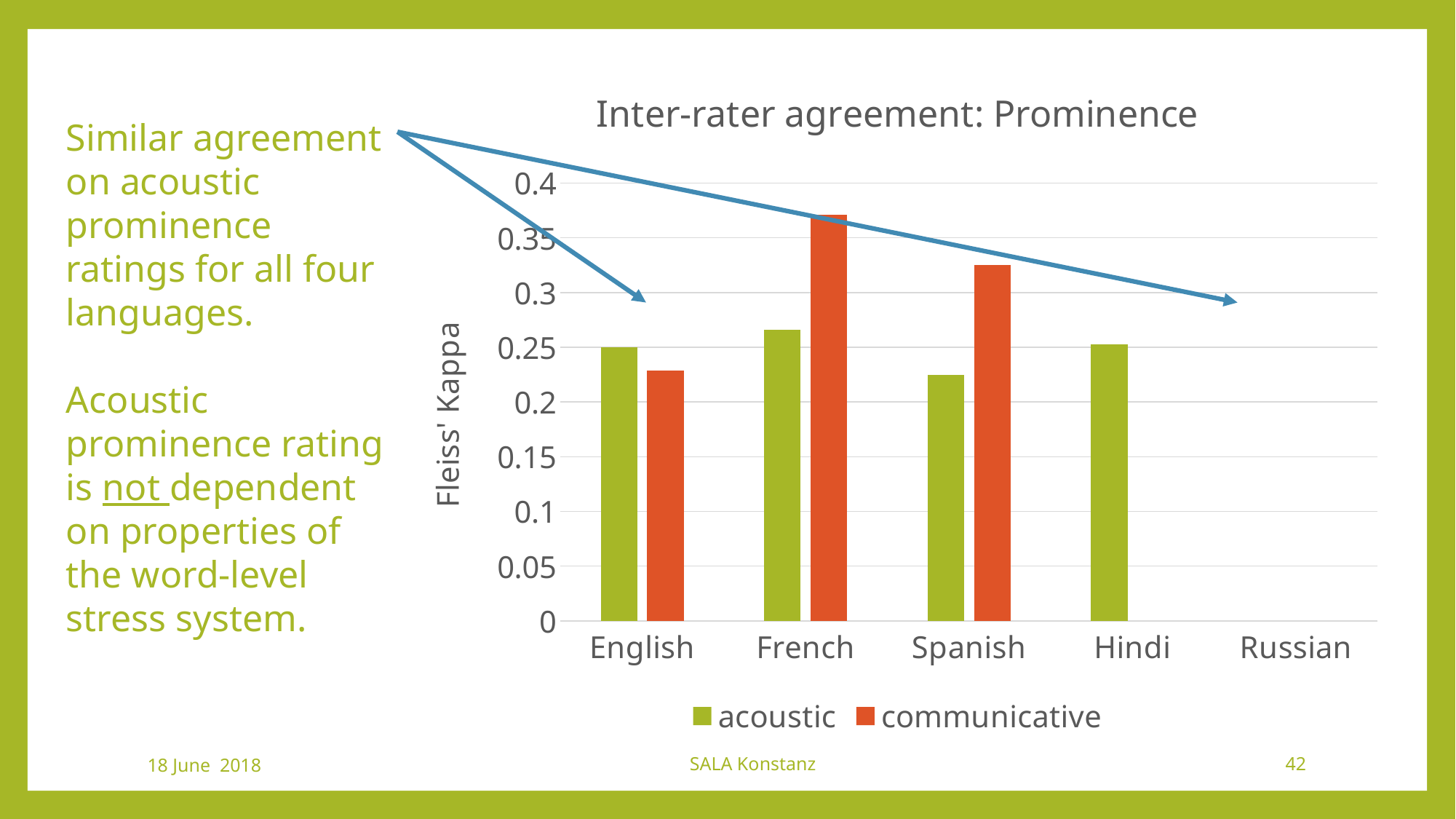
What is the label of the y axis? Fleiss' Kappa Is the communicative value for Spanish greater or less than 0.3? greater Which language has the highest communicative value? French What kind of chart is shown on the slide? bar chart Is the communicative value for French greater or less than 0.35? greater How many series does the legend list? 2 For French, which is larger: the acoustic value or the communicative value? communicative Is the acoustic value for Spanish greater or less than 0.25? less Which language category has no bars plotted? Russian How many language categories are shown on the x axis? 5 Which language has the lowest acoustic value? Spanish